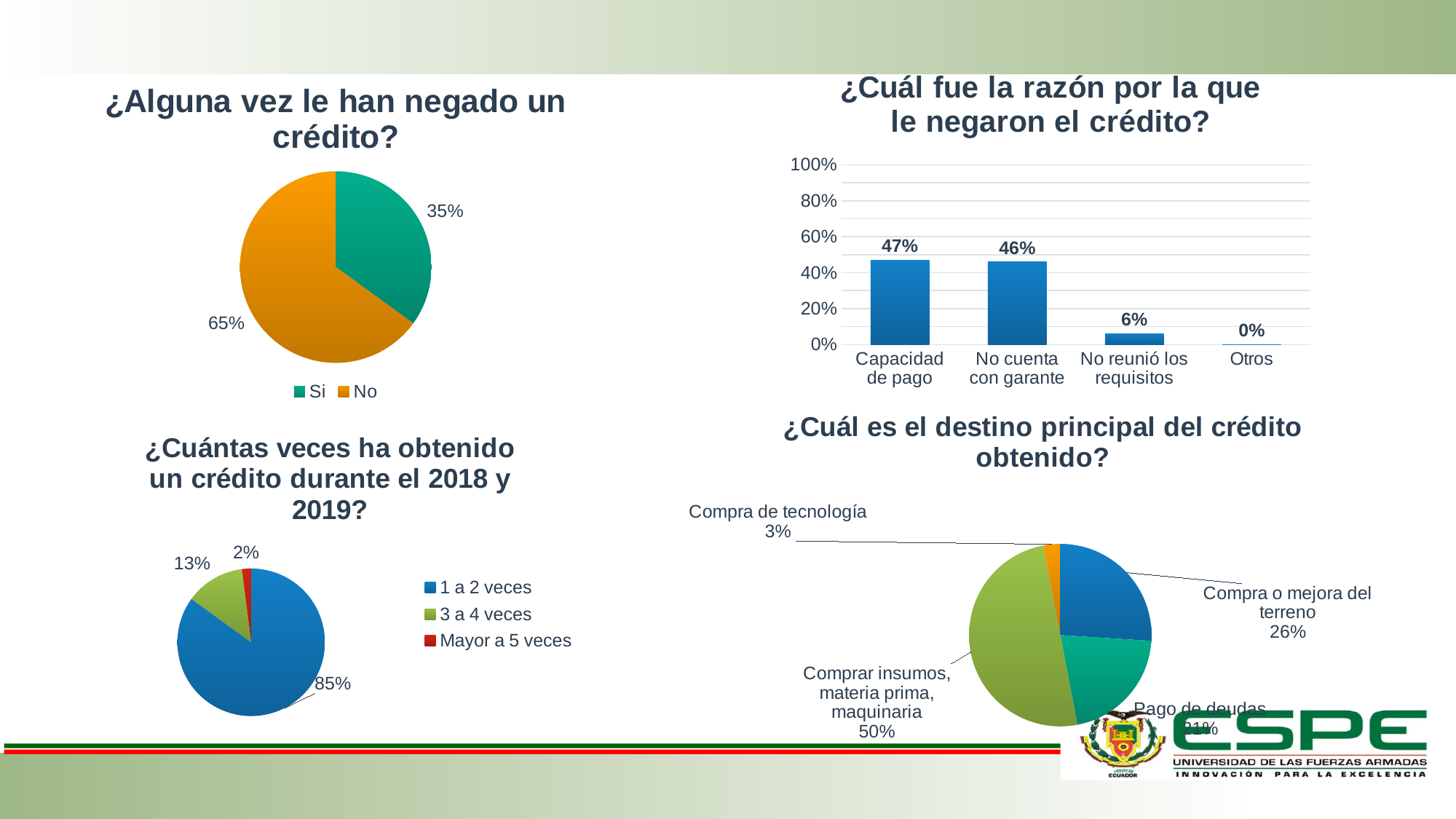
In the chart '¿Cuál fue la razón por la que le negaron el crédito?', what is the value for 'Capacidad de pago'? 47% In the chart '¿Cuál fue la razón por la que le negaron el crédito?', what is the difference between 'No cuenta con garante' and 'No reunió los requisitos'? 40% In the chart '¿Cuál fue la razón por la que le negaron el crédito?', which category has the lowest value? Otros In the chart '¿Cuántas veces ha obtenido un crédito durante el 2018 y 2019?', which category has the largest share? 1 a 2 veces In the chart '¿Alguna vez le han negado un crédito?', what percentage answered 'Si'? 35% How many categories are shown in the chart '¿Cuál fue la razón por la que le negaron el crédito?'? 4 In the chart '¿Cuántas veces ha obtenido un crédito durante el 2018 y 2019?', what is the share for '3 a 4 veces'? 13% How many entries does the legend list in the chart '¿Cuántas veces ha obtenido un crédito durante el 2018 y 2019?'? 3 What kind of chart is '¿Cuál fue la razón por la que le negaron el crédito?'? Bar chart What kind of chart is '¿Alguna vez le han negado un crédito?'? Pie chart In the chart '¿Alguna vez le han negado un crédito?', what percentage answered 'No'? 65% In the chart '¿Cuál es el destino principal del crédito obtenido?', what is the share for 'Compra o mejora del terreno'? 26%